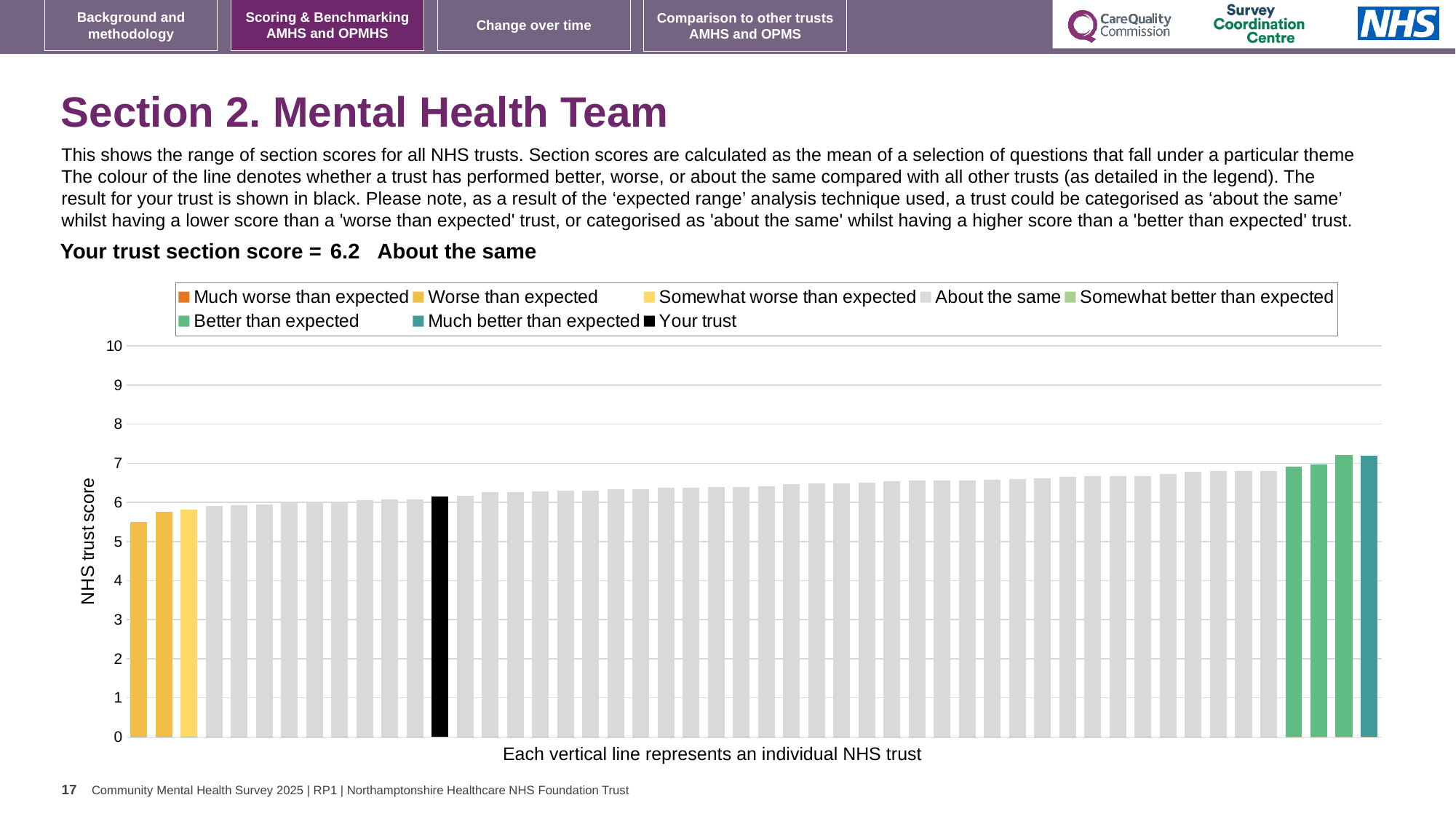
How many entries does the chart legend list? 8 What is the label on the vertical axis of the chart? NHS trust score What is the section score for Your trust shown on the slide? 6.2 Which category is Your trust placed in according to the text above the chart? About the same How many bars are coloured teal for 'Much better than expected'? 1 Is the value of the leftmost bar greater or less than 6? less Is the black bar for Your trust taller or shorter than the leftmost bar? taller What kind of chart is shown on the slide? bar chart Is the value for Your trust (the black bar) greater or less than 6? greater Is the value of the tallest bar greater or less than 8? less Do the bar values rise or fall from left to right along the x axis? rise